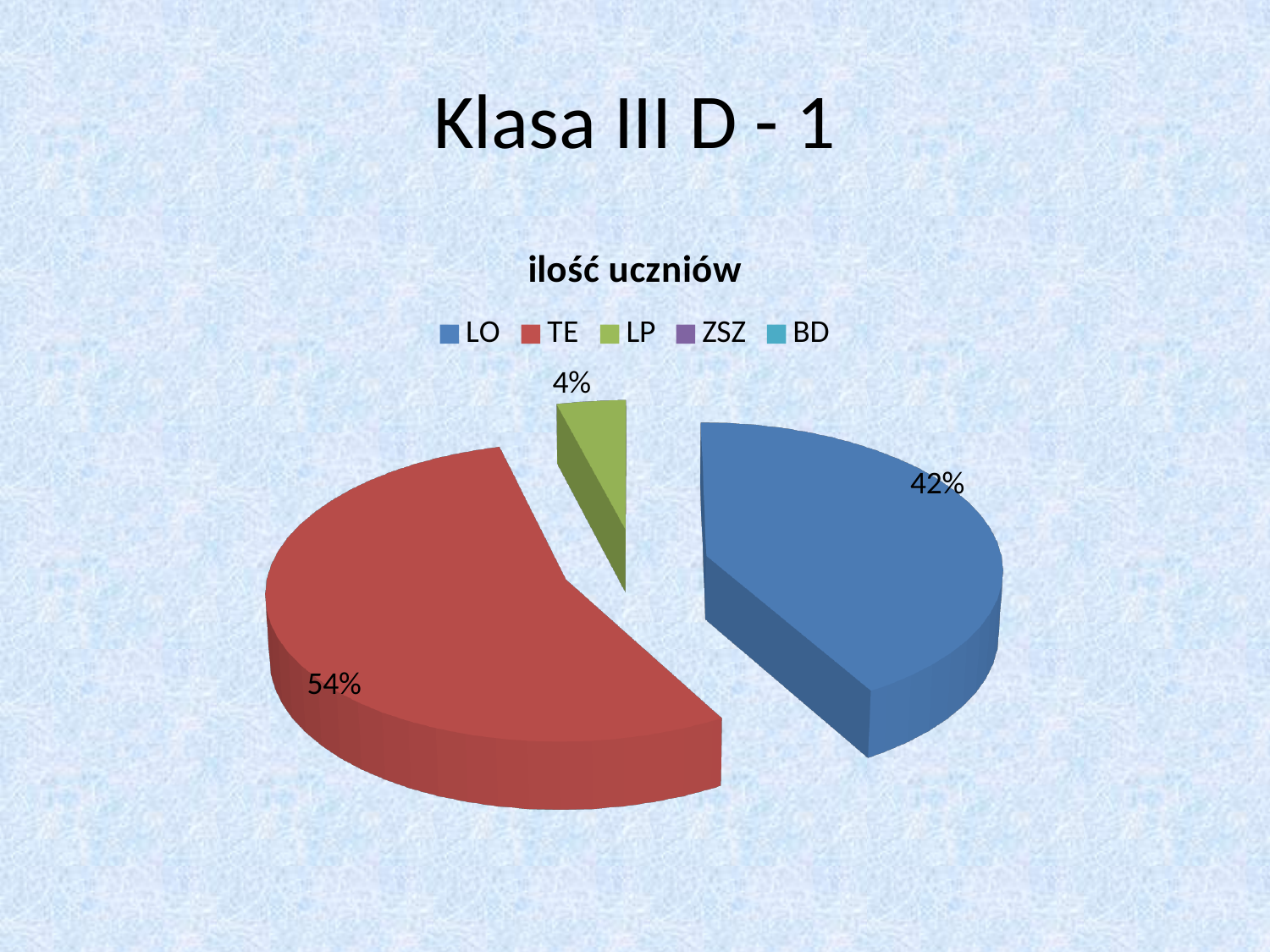
What kind of chart is shown on the slide? pie chart How many entries does the chart legend list? 5 What is the difference in percentage points between the TE and LO slices? 12 What is the difference in percentage points between the LO and LP slices? 38 Which category has the largest slice of the pie? TE What is the title of the chart? ilość uczniów Which slice is larger, LO or TE? TE What share of the pie does the LP slice represent? 4% Which colour represents the LO category in the legend? blue Which of the visible slices is the smallest? LP What share of the pie does the TE slice represent? 54% What share of the pie does the LO slice represent? 42%